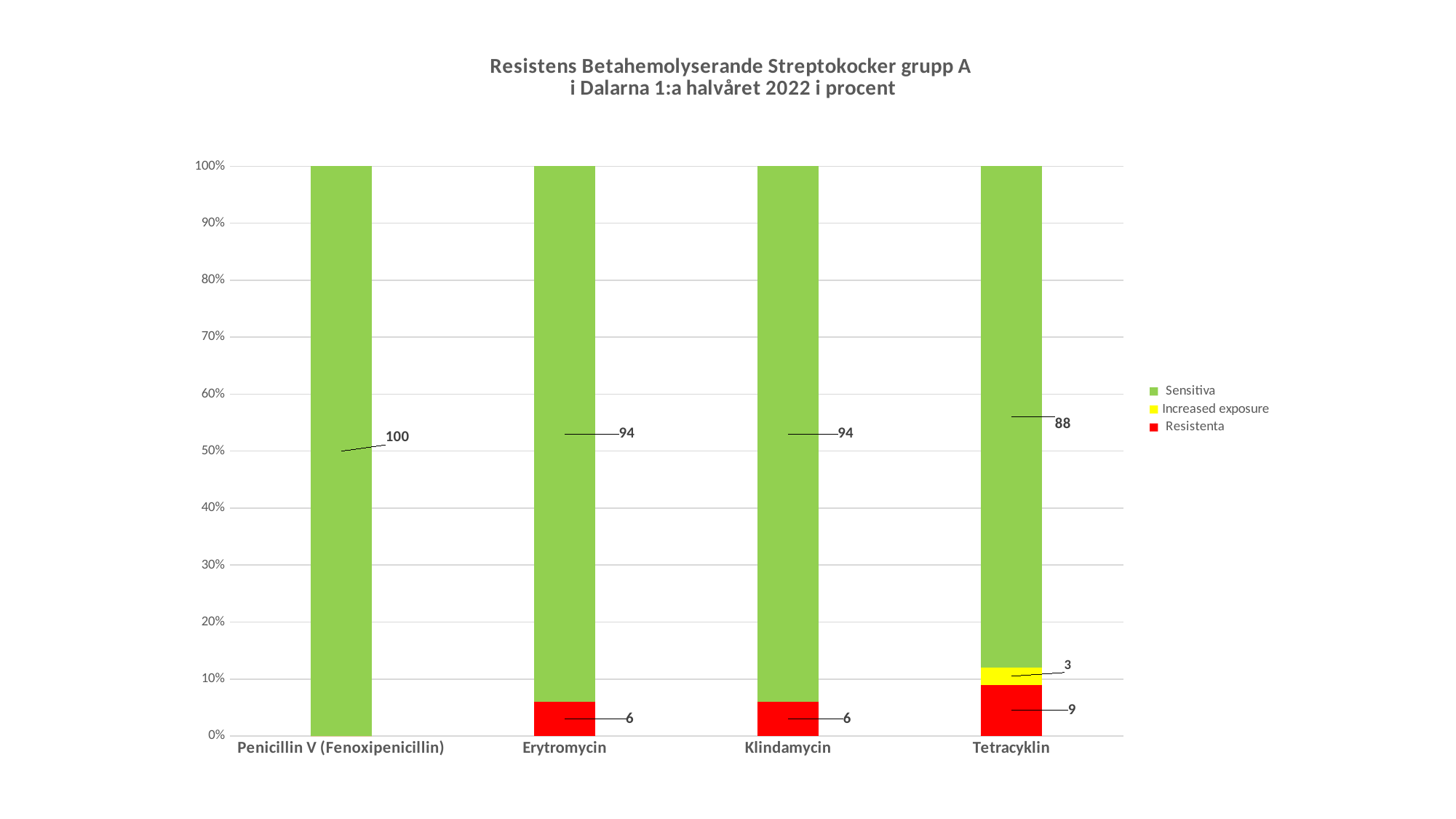
How many series does the legend list? 3 What kind of chart is shown on the slide? stacked bar chart What is the difference between the Sensitiva values for Penicillin V (Fenoxipenicillin) and Tetracyklin? 12 Which colour represents the Increased exposure series? yellow Which antibiotic has the highest Resistenta value? Tetracyklin What is the Sensitiva value for Tetracyklin? 88 What is the Increased exposure value for Tetracyklin? 3 What is the Resistenta value for Erytromycin? 6 Which antibiotic has the lowest Sensitiva value? Tetracyklin Is the Resistenta value for Tetracyklin larger or smaller than the Resistenta value for Klindamycin? larger What is the Sensitiva value for Penicillin V (Fenoxipenicillin)? 100 How many antibiotics are shown on the x axis? 4